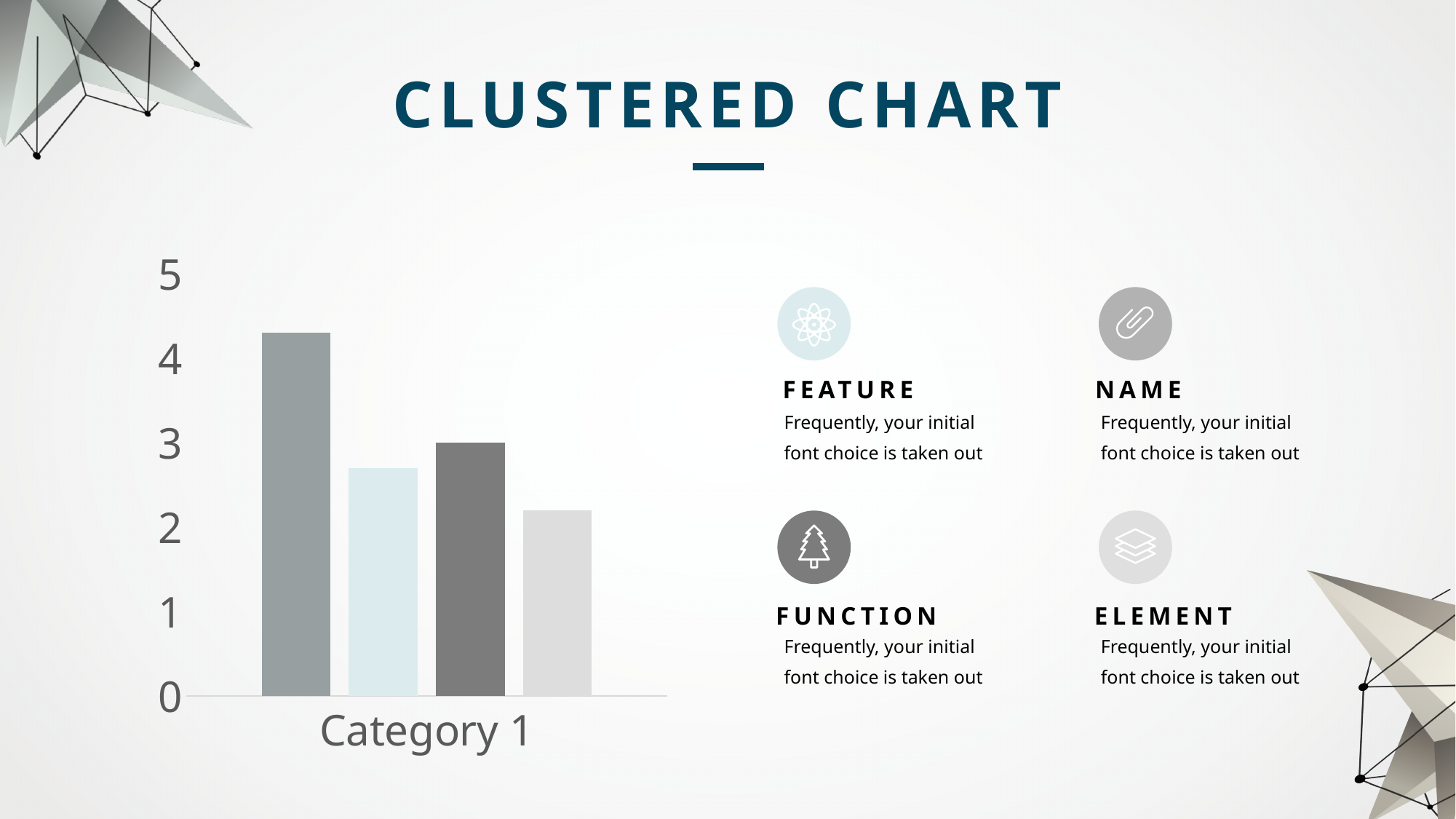
What kind of chart is shown on the slide? bar chart Which is larger, the first bar or the third bar? the first bar How many bars are plotted in the chart? 4 What is the label of the category on the x axis? Category 1 Which is larger, the second bar or the fourth bar? the second bar What is the title of the slide containing the chart? CLUSTERED CHART Is the value of the second bar from the left greater or less than 3? less Which bar in the chart is the shortest? the rightmost (fourth) bar Is the value of the leftmost bar greater or less than 4? greater Is the value of the rightmost bar greater or less than 3? less How many categories are shown on the x axis of the chart? 1 Which bar in the chart is the tallest? the leftmost (first) bar